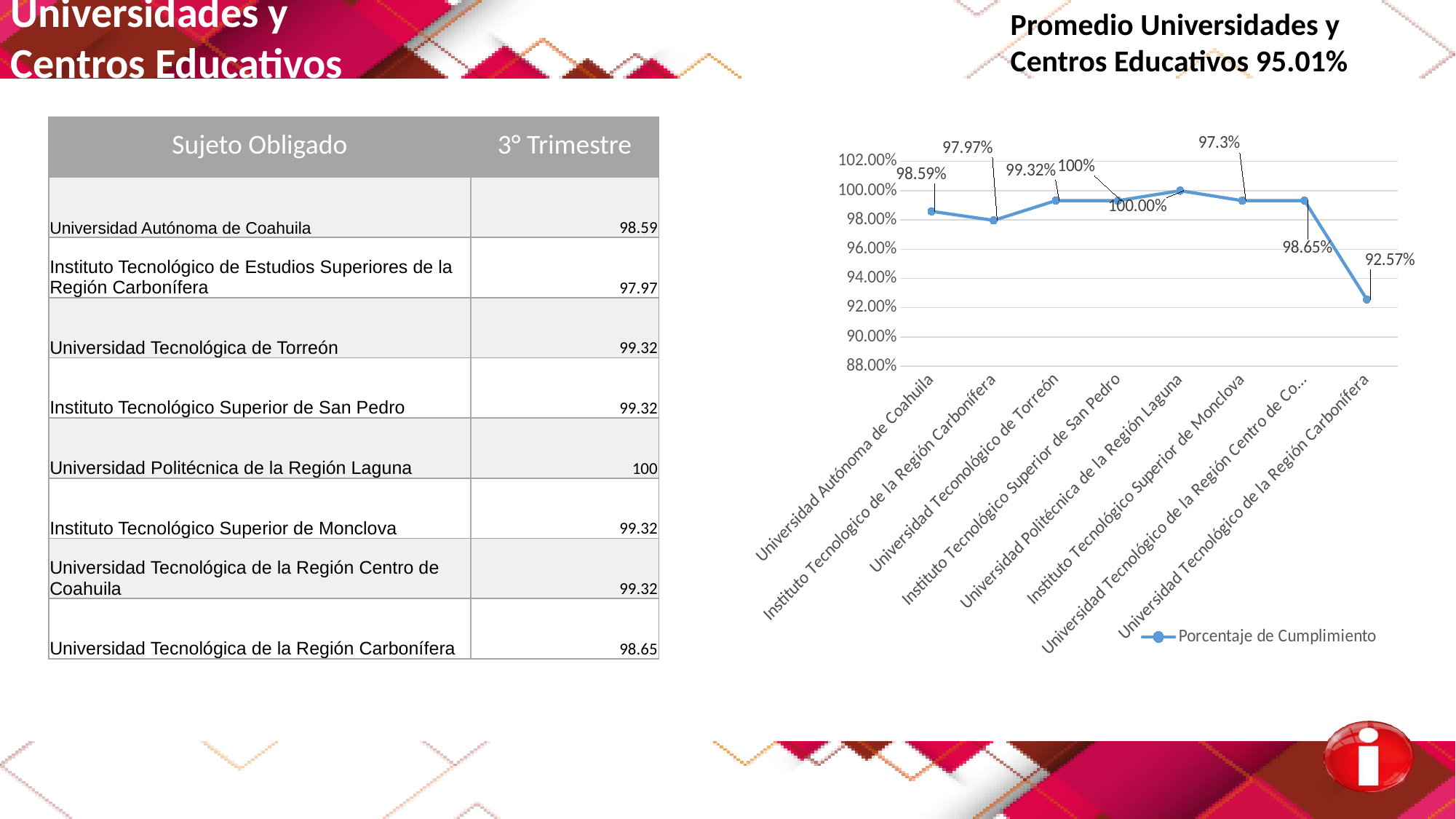
What is the difference between the labelled values for Universidad Autónoma de Coahuila (98.59%) and Universidad Tecnológico de la Región Carbonífera (92.57%)? 6.02% Which institution has the lowest value in the chart? Universidad Tecnológico de la Región Carbonífera What is the value labelled for Universidad Autónoma de Coahuila in the chart? 98.59% Which institution has the highest value in the chart? Universidad Politécnica de la Región Laguna What kind of chart is shown on the slide? line chart What is the name of the series shown in the chart legend? Porcentaje de Cumplimiento What is the value labelled for the last point, Universidad Tecnológico de la Región Carbonífera? 92.57% Which is larger in the chart: the value for Universidad Autónoma de Coahuila or the value for Instituto Tecnologico de la Región Carbonífera? Universidad Autónoma de Coahuila What is the value labelled for Instituto Tecnologico de la Región Carbonífera in the chart? 97.97% How many series does the chart legend list? 1 How many institutions are plotted along the x axis of the chart? 8 Is the value for Universidad Tecnológico de la Región Carbonífera greater or less than 94.00%? less